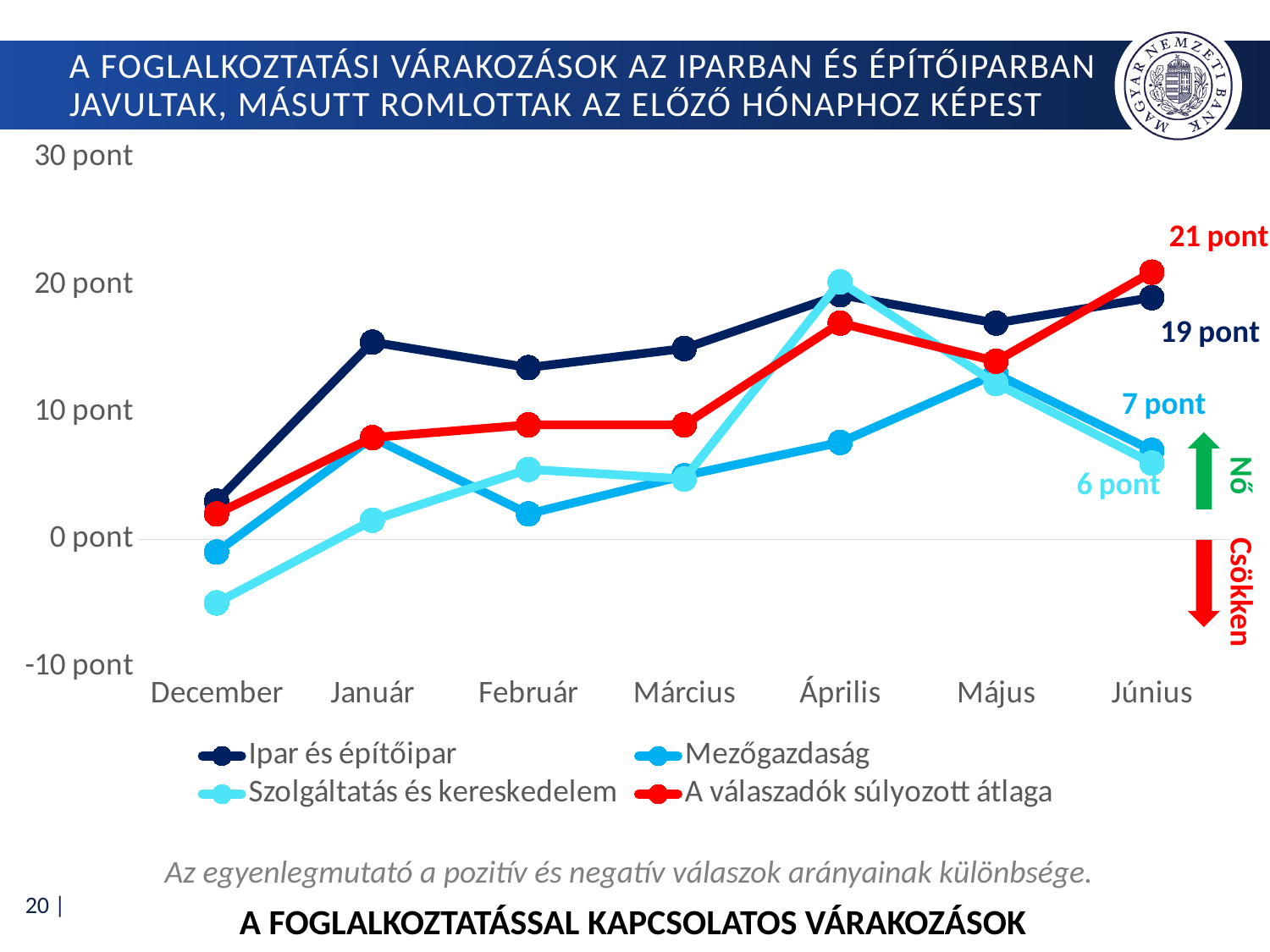
What kind of chart is shown on the slide? line chart What is the value for Mezőgazdaság in Június? 7 pont Which series has the lowest value in Június? Szolgáltatás és kereskedelem How many months are shown on the x axis? 7 How many series does the legend list? 4 What is the value for Szolgáltatás és kereskedelem in Június? 6 pont What is the difference between A válaszadók súlyozott átlaga and Ipar és építőipar in Június? 2 pont What is the value for Ipar és építőipar in Június? 19 pont What is the value for A válaszadók súlyozott átlaga in Június? 21 pont Is the value for Ipar és építőipar in Április greater or less than 10 pont? greater Is the value for Szolgáltatás és kereskedelem in December greater or less than 0 pont? less Which series has the highest value in Június? A válaszadók súlyozott átlaga